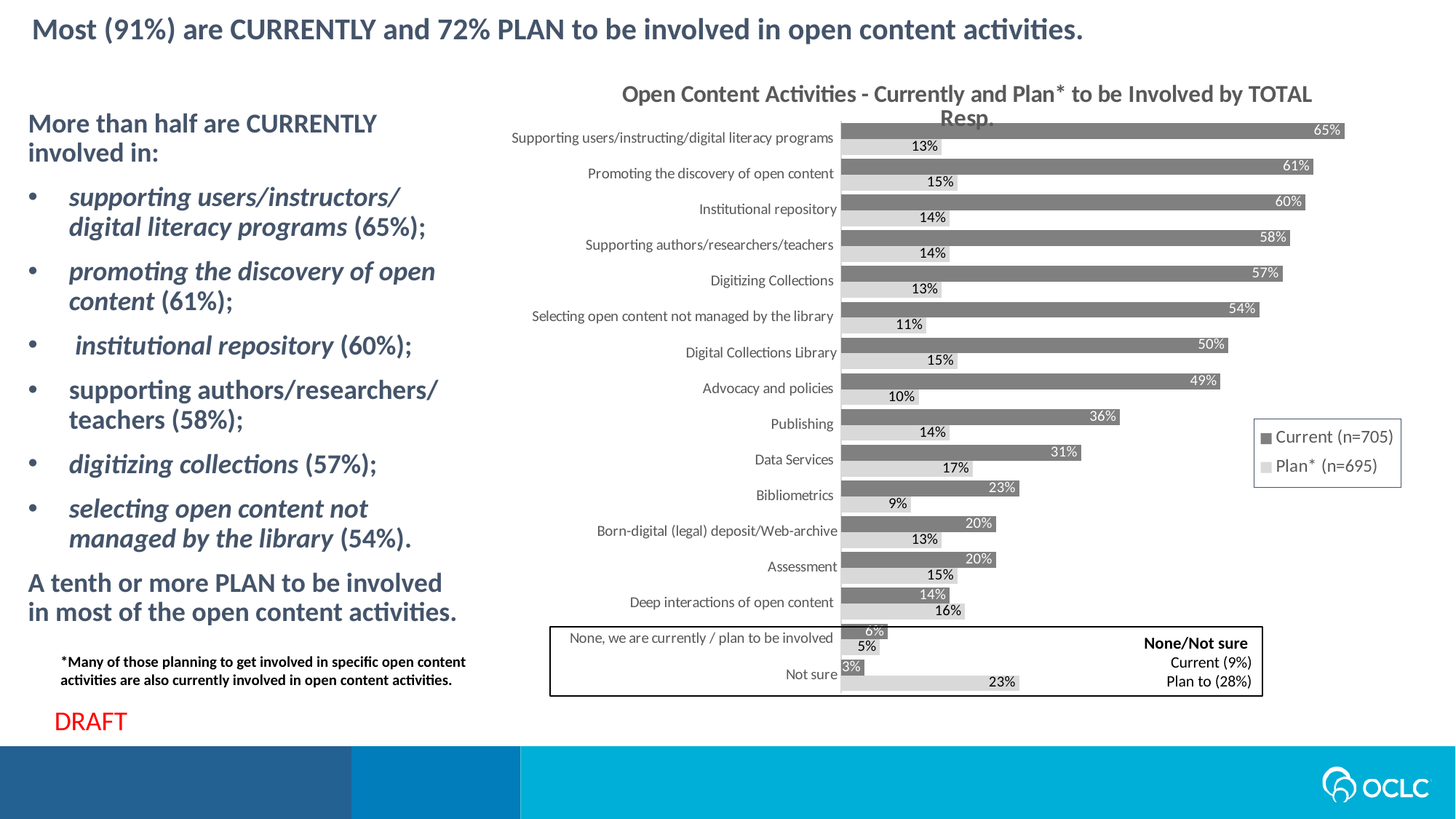
What is the Plan value for Not sure? 23% How many categories are shown on the chart? 16 How many series does the chart legend list? 2 What is the difference between the Current and Plan values for Digitizing Collections? 44% What kind of chart is shown on the slide? bar chart What is the Plan value for Data Services? 17% For Deep interactions of open content, which is larger: the Current value or the Plan value? Plan What is the sample size (n) shown in the legend for the Current series? 705 Which category has the lowest Current value? Not sure Which category has the highest Current value? Supporting users/instructing/digital literacy programs What is the Current value for Institutional repository? 60% Which has a higher Current value: Publishing or Bibliometrics? Publishing